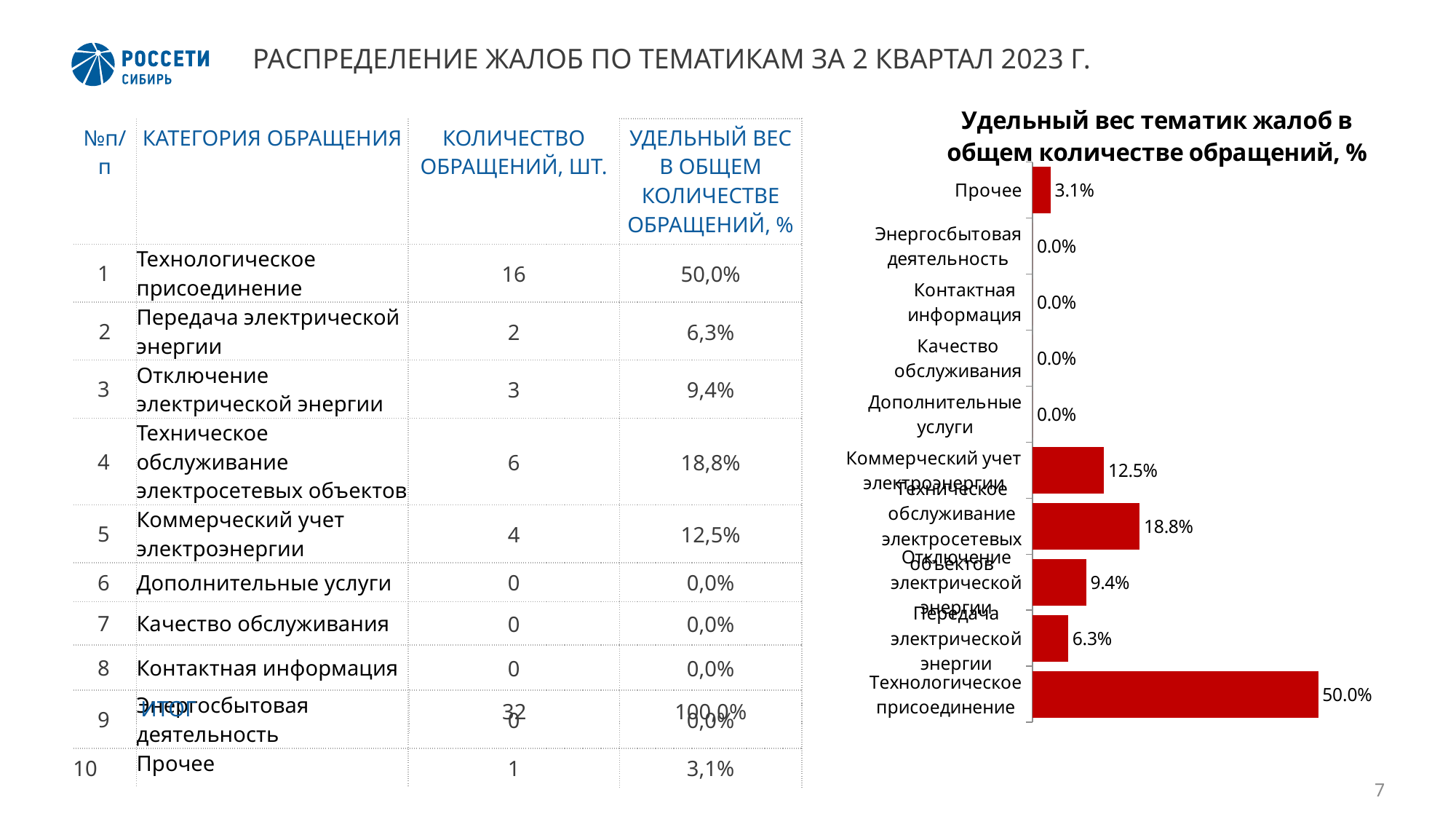
How many categories in the chart have a value of 0.0%? 4 Which category has the highest value in the chart? Технологическое присоединение What is the value for Коммерческий учет электроэнергии in the chart? 12.5% What type of chart is shown on the slide? bar chart Which is larger: the value for Коммерческий учет электроэнергии or the value for Отключение электрической энергии? Коммерческий учет электроэнергии What is the title of the chart? Удельный вес тематик жалоб в общем количестве обращений, % What is the difference between the values for Технологическое присоединение and Техническое обслуживание электросетевых объектов? 31.2% What is the value for Передача электрической энергии in the chart? 6.3% How many categories are shown in the chart? 10 What is the difference between the values for Отключение электрической энергии and Передача электрической энергии? 3.1% What is the value for Технологическое присоединение in the chart? 50.0% What is the value for Прочее in the chart? 3.1%